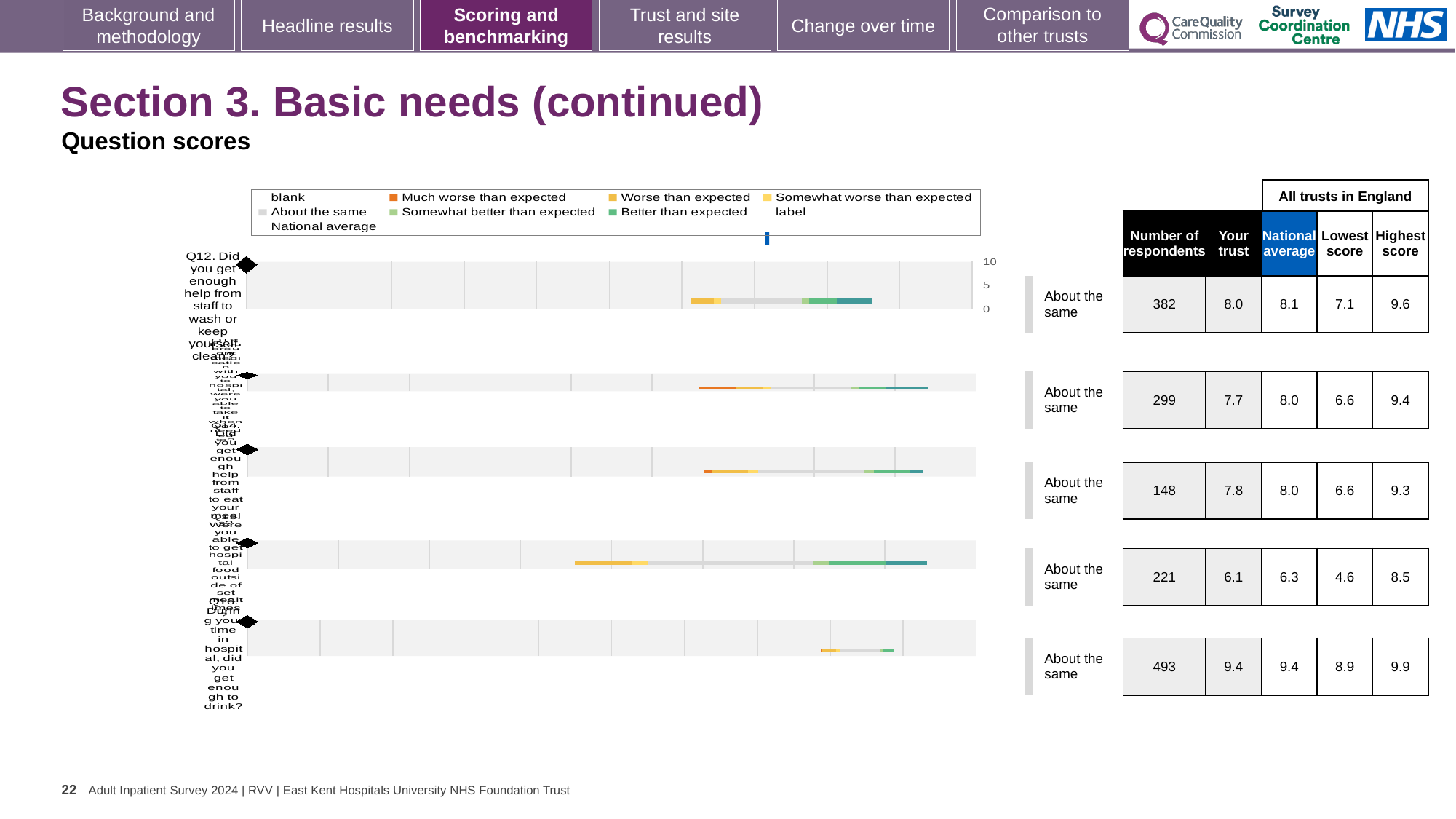
What is the highest score across all trusts in England for the last question row (enough to drink)? 9.9 What is the 'Your trust' score for Q12 (help from staff to wash or keep yourself clean)? 8.0 What is the national average for the fourth question row in the table? 6.3 What kind of chart is used to show the question scores on this slide? bar chart How many entries does the chart legend list? 9 What is the number of respondents for Q12 (help from staff to wash or keep yourself clean)? 382 What benchmark category is given for every question row on this slide? About the same Which question row has the highest number of respondents? the last row (493) Which legend entry is shown in orange? Much worse than expected What is the difference between the national average and the 'Your trust' score for Q12? 0.1 Which question row has the lowest 'Your trust' score in the table? the fourth row (6.1) How many question rows are plotted in the chart? 5